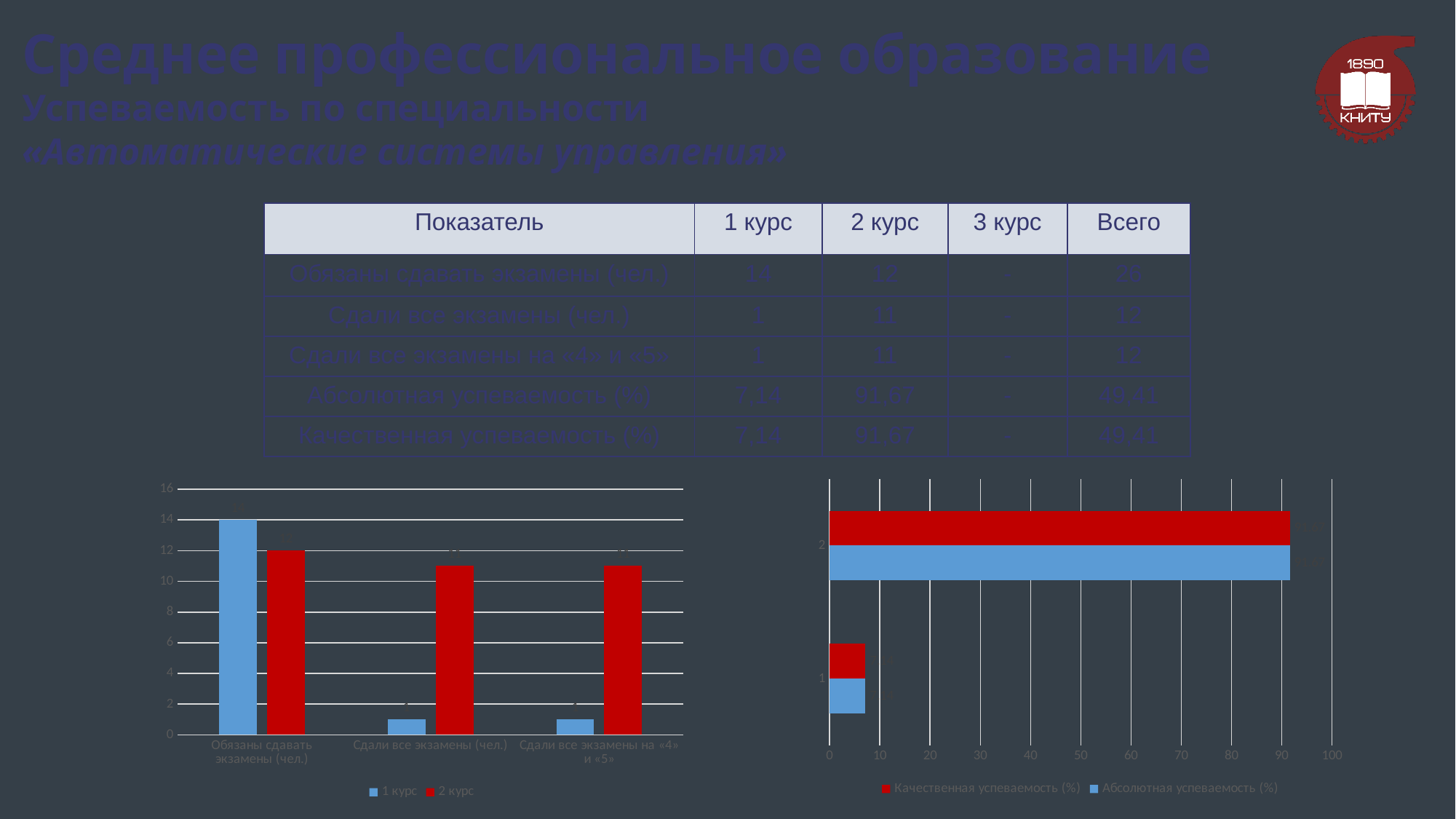
What kind of chart is the chart on the left of the slide? bar chart In the left chart, is the value for 1 курс in «Сдали все экзамены (чел.)» greater or less than 4? less In the left chart, what is the value for 1 курс in the category «Обязаны сдавать экзамены (чел.)»? 14 In the left chart, is the value for 2 курс in «Сдали все экзамены на «4» и «5»» greater or less than 8? greater In the left chart, what is the value for 2 курс in the category «Обязаны сдавать экзамены (чел.)»? 12 In the right chart, is the value of Абсолютная успеваемость (%) for category 2 greater or less than 80? greater How many series does the legend of the right chart list? 2 In the left chart, what is the difference between the 1 курс and 2 курс values for «Обязаны сдавать экзамены (чел.)»? 2 In the left chart, which series has the larger value for «Обязаны сдавать экзамены (чел.)», 1 курс or 2 курс? 1 курс What kind of chart is the chart on the right of the slide? bar chart How many categories are shown on the x axis of the left chart? 3